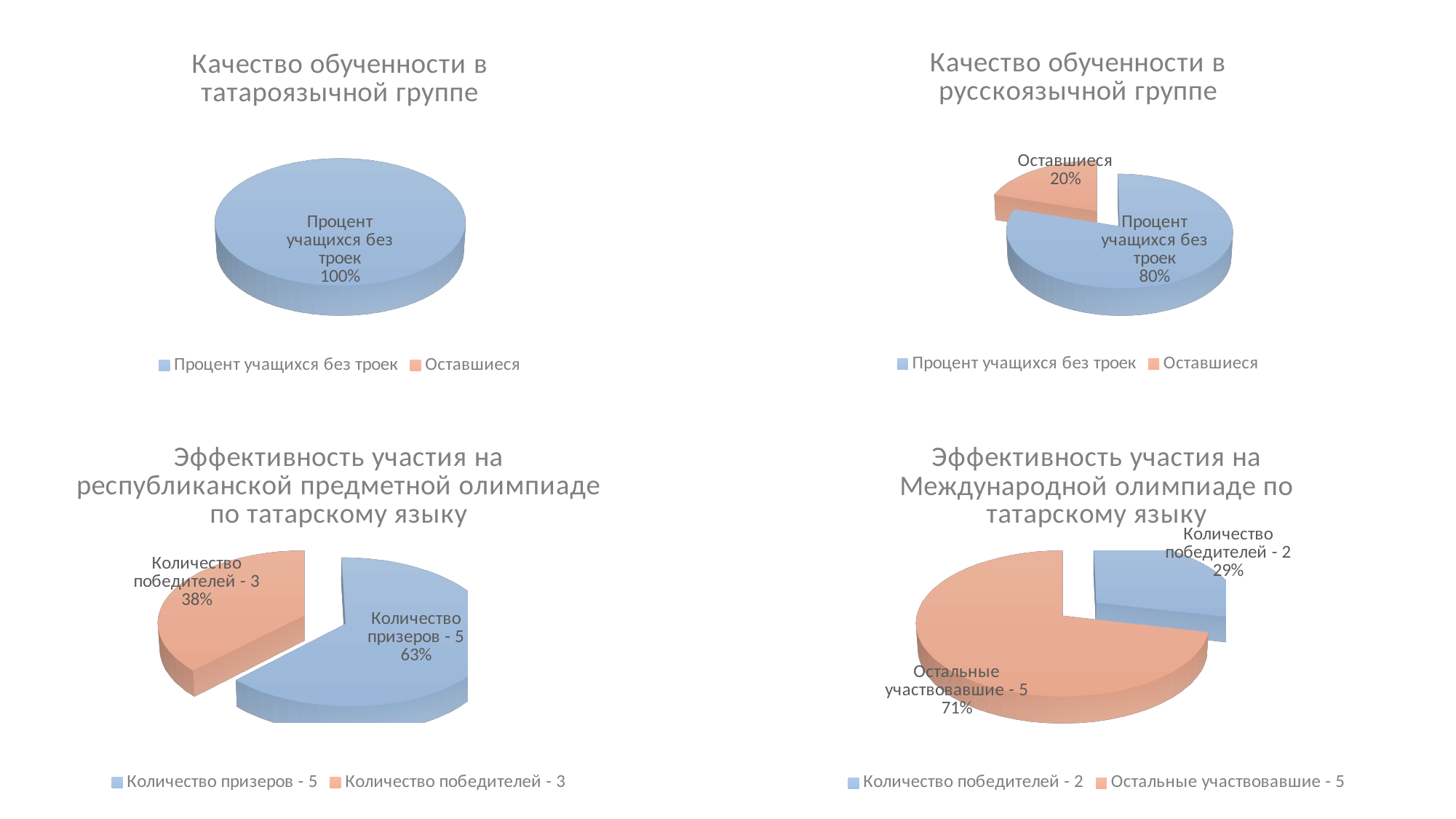
In the chart titled "Качество обученности в русскоязычной группе", what share is shown for "Процент учащихся без троек"? 80% In the chart titled "Эффективность участия на республиканской предметной олимпиаде по татарскому языку", what share is shown for "Количество победителей - 3"? 38% In the chart titled "Качество обученности в русскоязычной группе", what is the difference in percentage points between "Процент учащихся без троек" and "Оставшиеся"? 60 In the chart titled "Качество обученности в татароязычной группе", what share is shown for "Процент учащихся без троек"? 100% How many entries does the legend of the top-left chart list? 2 What kind of chart is the bottom-right chart on the slide? Pie chart In the chart titled "Качество обученности в русскоязычной группе", what share is shown for "Оставшиеся"? 20% In the chart titled "Эффективность участия на республиканской предметной олимпиаде по татарскому языку", which slice is the largest? Количество призеров - 5 In the chart titled "Эффективность участия на Международной олимпиаде по татарскому языку", which slice is the smallest? Количество победителей - 2 In the chart titled "Эффективность участия на Международной олимпиаде по татарскому языку", what share is shown for "Остальные участвовавшие - 5"? 71% In the chart titled "Качество обученности в русскоязычной группе", which slice is larger: "Процент учащихся без троек" or "Оставшиеся"? Процент учащихся без троек In the chart titled "Эффективность участия на республиканской предметной олимпиаде по татарскому языку", what share is shown for "Количество призеров - 5"? 63%